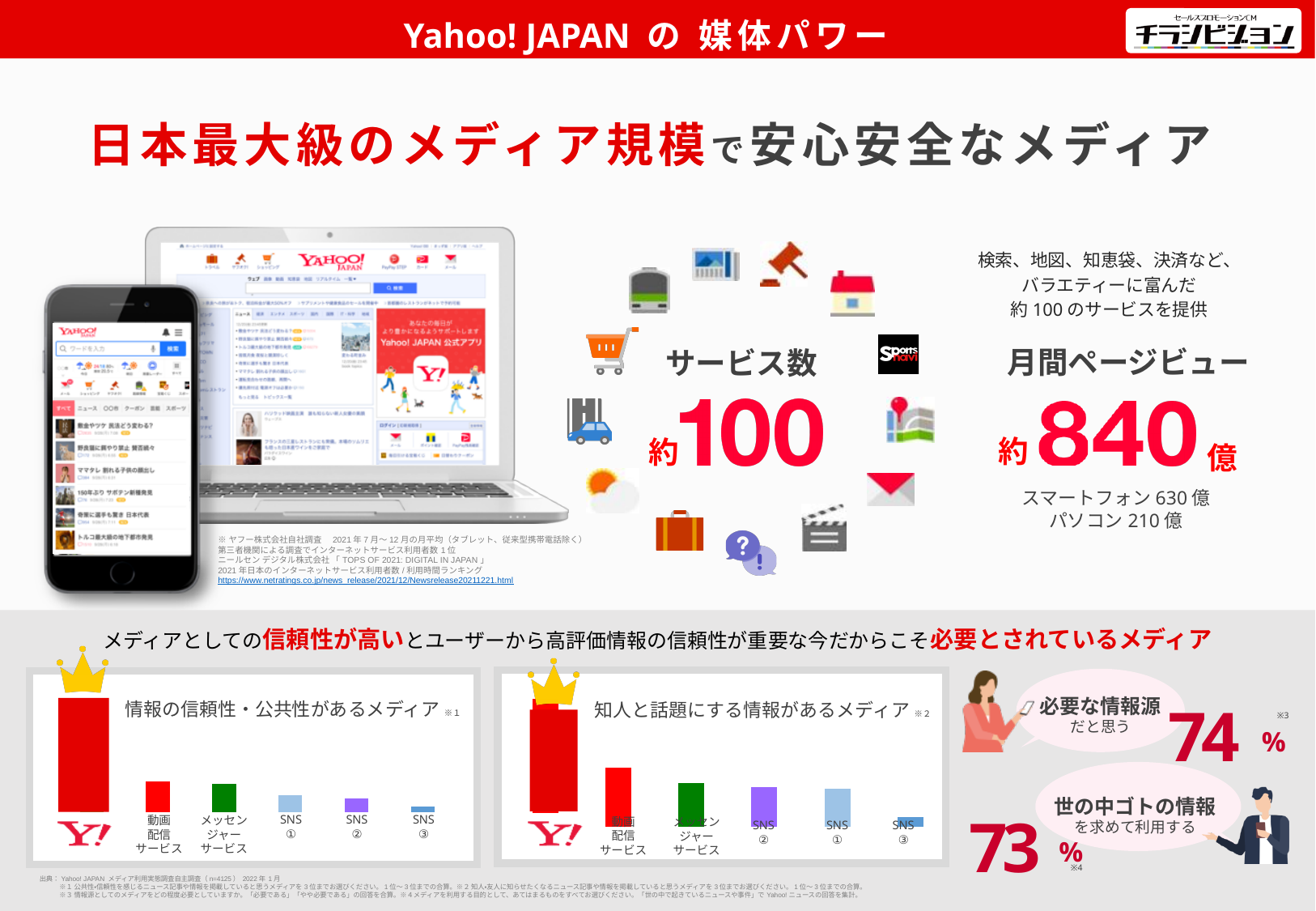
In the chart titled 知人と話題にする情報があるメディア, which category has the tallest bar? Y! (Yahoo! JAPAN) In the chart titled 情報の信頼性・公共性があるメディア, what colour is the tallest bar? red In the chart titled 知人と話題にする情報があるメディア, which is larger: SNS② or SNS③? SNS② In the chart titled 知人と話題にする情報があるメディア, how many categories are shown? 6 What kind of chart is the left chart titled 情報の信頼性・公共性があるメディア? bar chart What kind of chart is the right chart titled 知人と話題にする情報があるメディア? bar chart In the chart titled 情報の信頼性・公共性があるメディア, which is larger: メッセンジャーサービス or SNS①? メッセンジャーサービス In the chart titled 情報の信頼性・公共性があるメディア, which category has the shortest bar? SNS③ In the chart titled 情報の信頼性・公共性があるメディア, how many bars are plotted? 6 In the chart titled 知人と話題にする情報があるメディア, which category has the shortest bar? SNS③ In the chart titled 情報の信頼性・公共性があるメディア, which category has the tallest bar? Y! (Yahoo! JAPAN) In the chart titled 知人と話題にする情報があるメディア, which is larger: 動画配信サービス or メッセンジャーサービス? 動画配信サービス